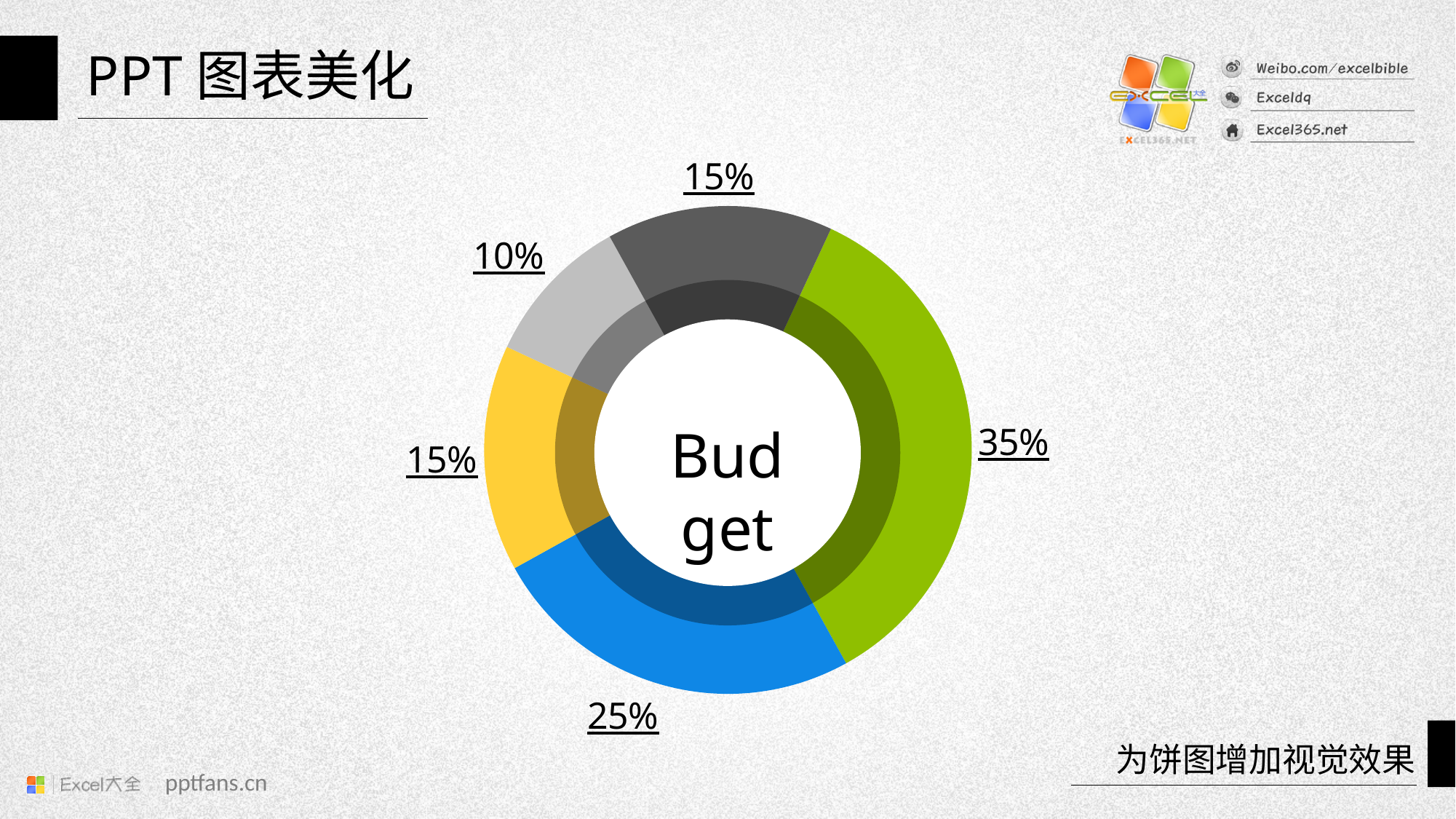
Which is larger in the doughnut chart, the blue slice or the yellow slice? The blue slice What percentage is shown for the green slice of the doughnut chart? 35% What is the difference between the green slice and the blue slice in the doughnut chart? 10% How many slices does the doughnut chart have? 5 What percentage is shown for the blue slice of the doughnut chart? 25% What percentage is shown for the yellow slice of the doughnut chart? 15% Which slice of the doughnut chart has the smallest share? The light gray slice (10%) Which slice of the doughnut chart has the largest share? The green slice (35%) What percentage is shown for the light gray slice of the doughnut chart? 10% What text appears in the centre of the doughnut chart? Budget What percentage is shown for the dark gray slice of the doughnut chart? 15% What kind of chart is shown on the slide? Doughnut chart